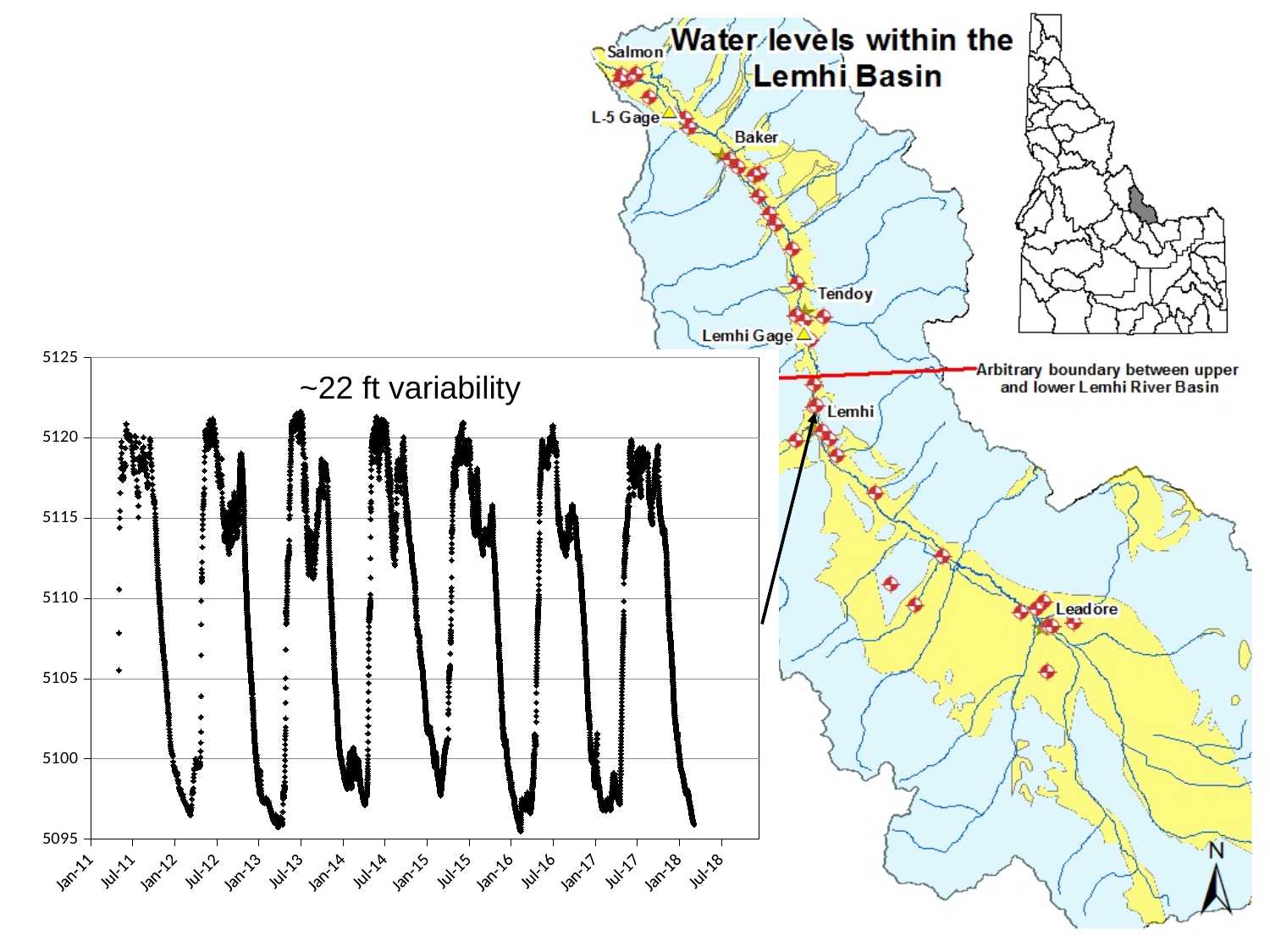
What annotation text is printed inside the chart area? ~22 ft variability How many tick labels are shown on the chart's x axis? 16 What is the last label on the chart's x axis? Jul-18 What kind of chart is shown on the left of the slide? scatter chart What is the highest value shown on the chart's y axis? 5125 Are the plotted values around Jul-11 greater or less than 5115? greater Do the plotted values rise steadily, fall steadily, or oscillate seasonally along the x axis? oscillate seasonally Are the plotted values around Jul-14 greater or less than 5110? greater Are the plotted values around Jan-12 greater or less than 5100? less